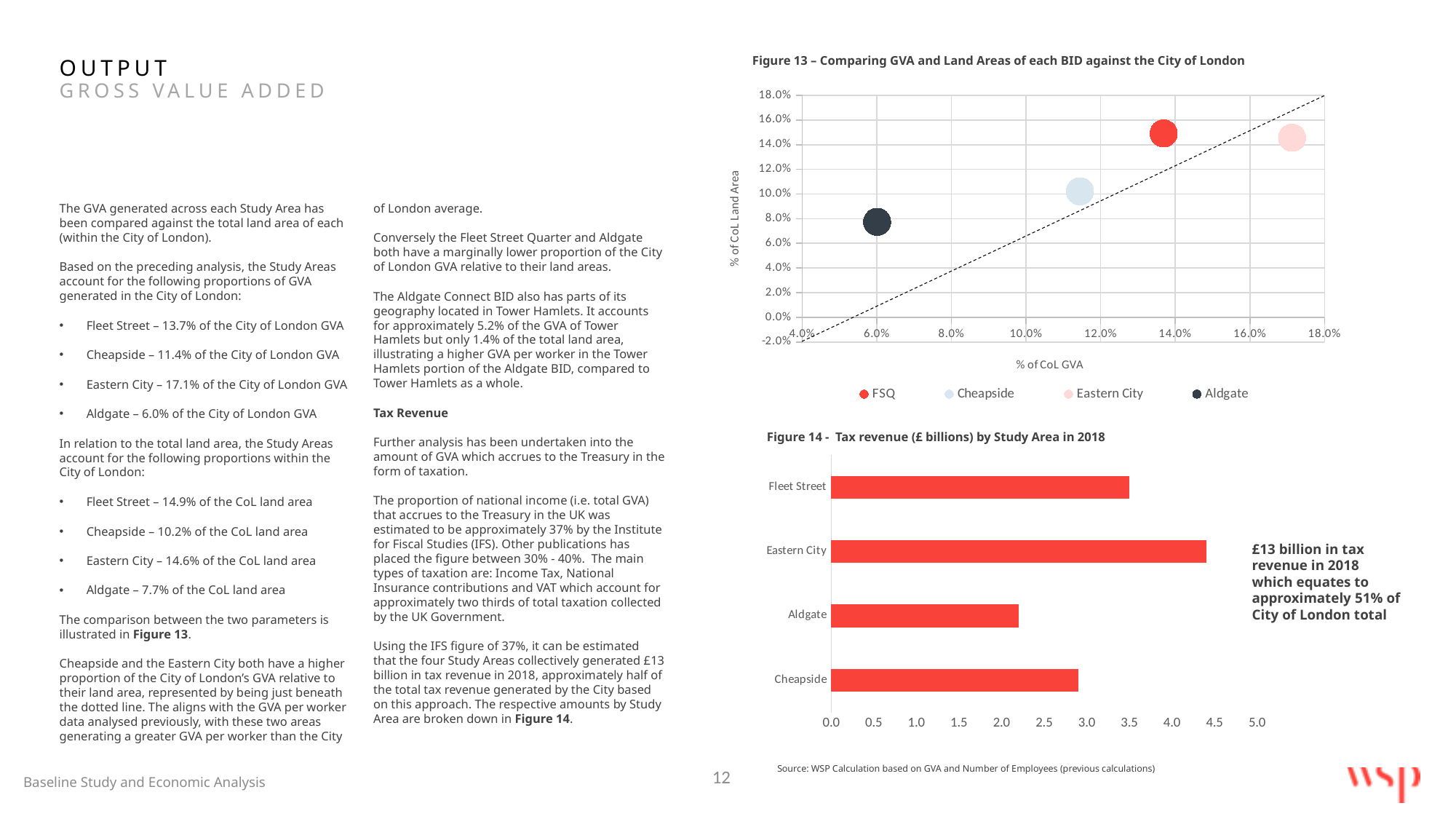
In Figure 14 - Tax revenue (£ billions) by Study Area in 2018, which study area has the highest tax revenue? Eastern City In Figure 14 - Tax revenue (£ billions) by Study Area in 2018, how many study areas are shown? 4 In Figure 14 - Tax revenue (£ billions) by Study Area in 2018, is the value for Eastern City greater or less than 4.0? greater In Figure 13 – Comparing GVA and Land Areas of each BID against the City of London, which BID has the lowest % of CoL GVA? Aldgate In Figure 14 - Tax revenue (£ billions) by Study Area in 2018, which is larger, the tax revenue for Fleet Street or for Cheapside? Fleet Street In Figure 13 – Comparing GVA and Land Areas of each BID against the City of London, which BID has the highest % of CoL GVA? Eastern City In Figure 14 - Tax revenue (£ billions) by Study Area in 2018, which study area has the lowest tax revenue? Aldgate How many series does the legend of Figure 13 – Comparing GVA and Land Areas of each BID against the City of London list? 4 In Figure 14 - Tax revenue (£ billions) by Study Area in 2018, is the value for Aldgate greater or less than 2.5? less What kind of chart is Figure 14 - Tax revenue (£ billions) by Study Area in 2018? bar chart In Figure 13 – Comparing GVA and Land Areas of each BID against the City of London, is the % of CoL Land Area for Aldgate greater or less than 10.0%? less What is the label of the x axis in Figure 13 – Comparing GVA and Land Areas of each BID against the City of London? % of CoL GVA